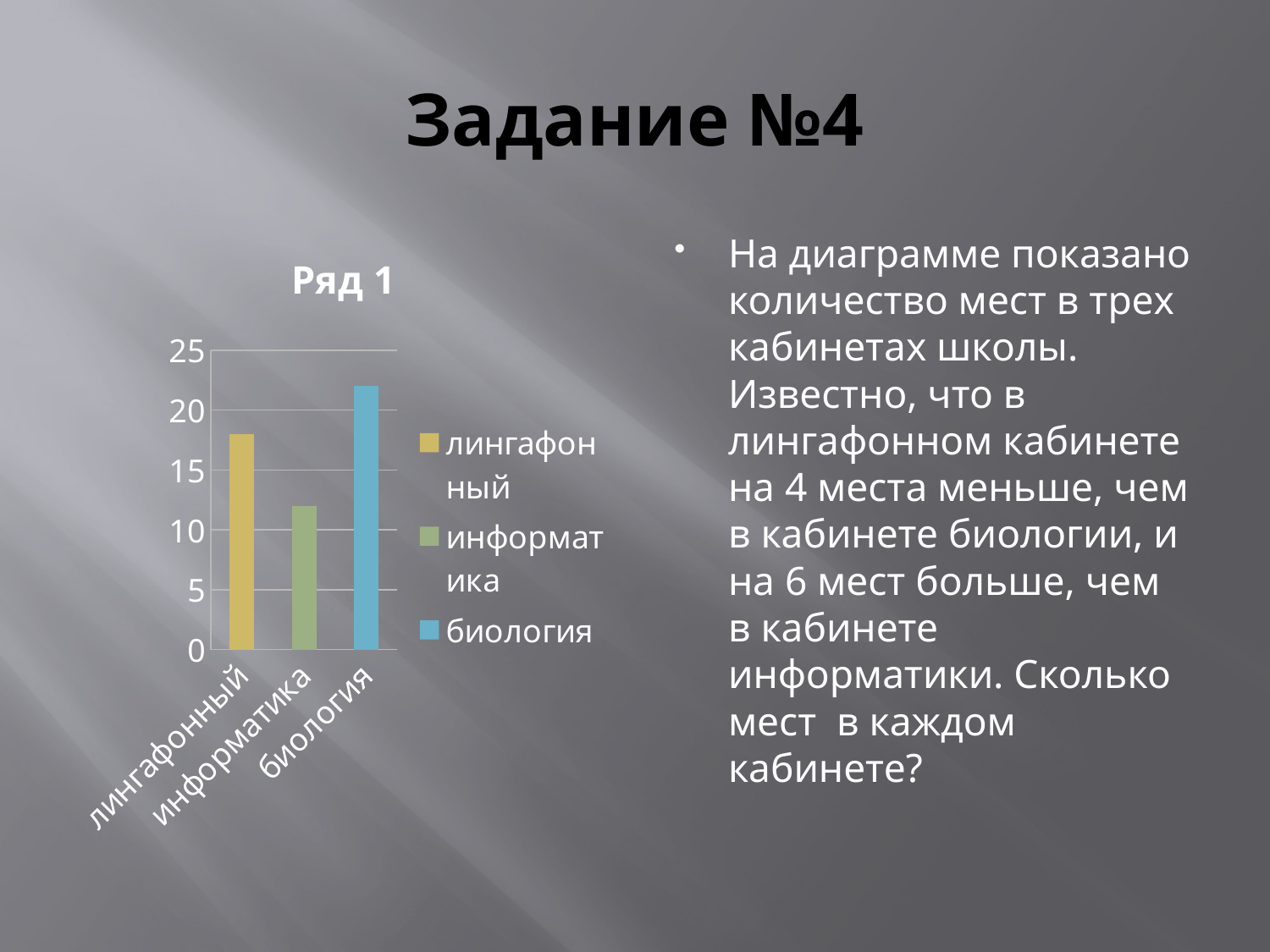
What is the title of the chart? Ряд 1 How many entries does the chart legend list? 3 Which category has the lowest bar in the chart? информатика Is the value for лингафонный greater or less than 15? greater Is the value for информатика greater or less than 10? greater Which is larger, the value for лингафонный or the value for информатика? лингафонный Is the value for биология greater or less than 20? greater How many categories are plotted in the chart? 3 Which category has the highest bar in the chart? биология What kind of chart is shown on the slide? bar chart Which is larger, the value for биология or the value for лингафонный? биология